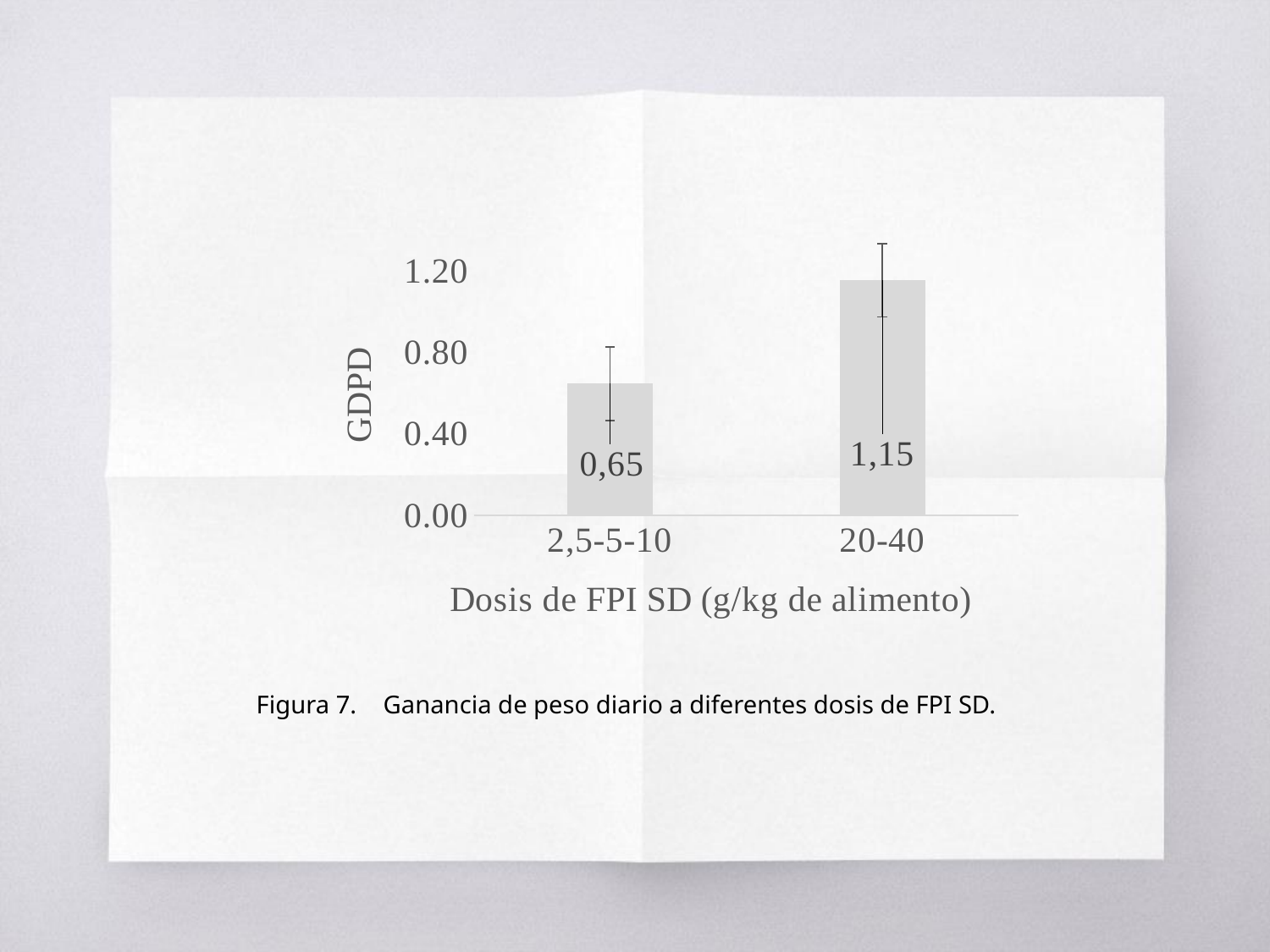
What is the label of the x axis? Dosis de FPI SD (g/kg de alimento) Which dose has a larger GDPD, 2,5-5-10 or 20-40? 20-40 Is the GDPD value for the 20-40 dose greater or less than 0.80? greater What is the GDPD value for the dose 2,5-5-10? 0,65 Which dose has the lowest GDPD? 2,5-5-10 Do the GDPD values rise or fall from the 2,5-5-10 dose to the 20-40 dose? rise What is the difference in GDPD between the 20-40 dose and the 2,5-5-10 dose? 0,50 What kind of chart is shown on the slide? bar chart What is the GDPD value for the dose 20-40? 1,15 How many dose categories are shown on the x axis? 2 Is the GDPD value for the 2,5-5-10 dose greater or less than 0.80? less Which dose has the highest GDPD? 20-40